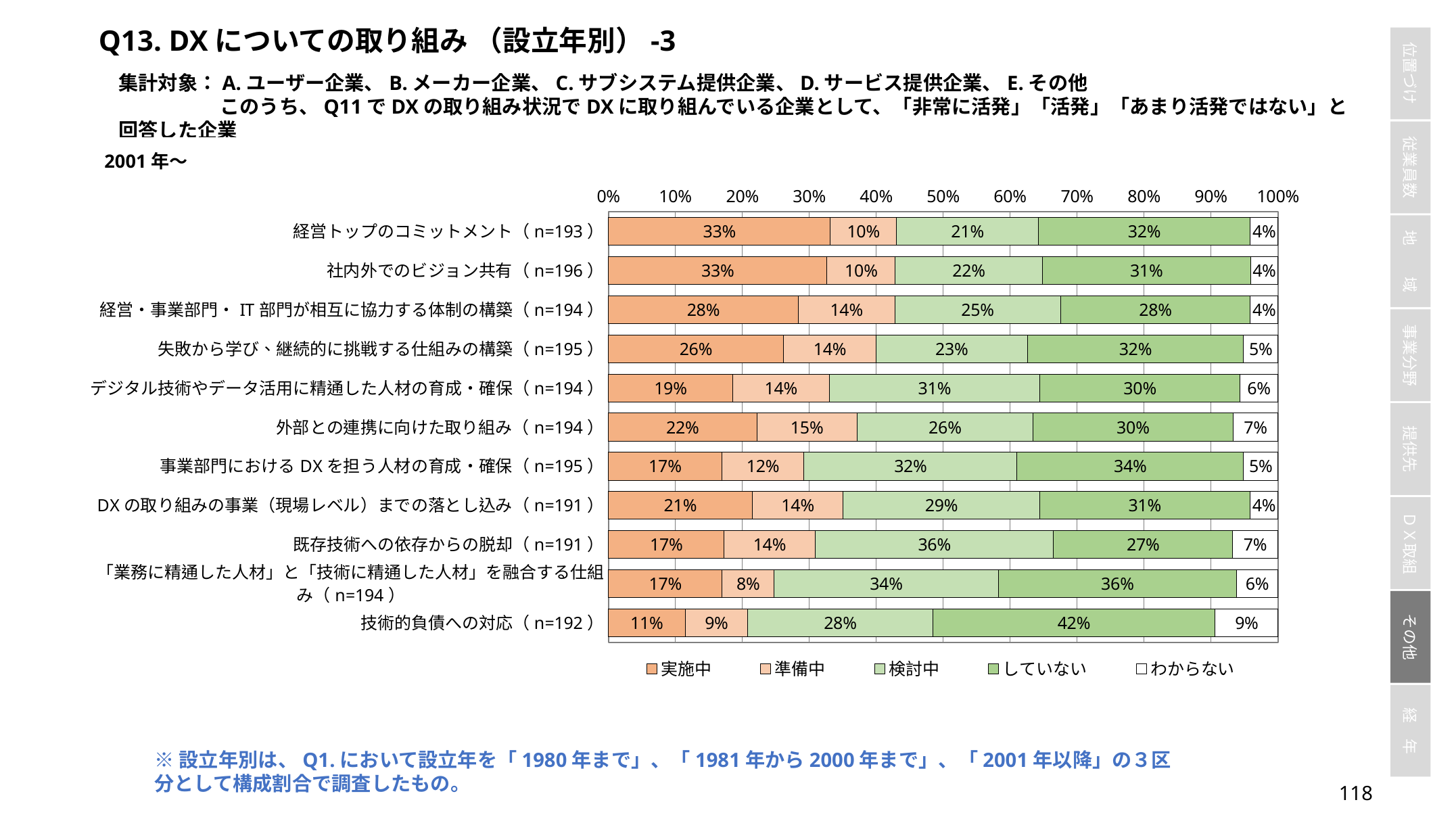
What is the していない value for 技術的負債への対応? 42% What is the difference between the 実施中 values for 経営トップのコミットメント and 技術的負債への対応? 22% Which category has the highest していない value? 技術的負債への対応 What is the 検討中 value for 既存技術への依存からの脱却? 36% Which category has the lowest 実施中 value? 技術的負債への対応 What type of chart is shown on the slide? Stacked bar chart What is the 実施中 value for 経営トップのコミットメント? 33% What is the sample size (n) shown for 社内外でのビジョン共有? n=196 Which is larger: the 検討中 value for 事業部門におけるDXを担う人材の育成・確保 or the 検討中 value for 外部との連携に向けた取り組み? 事業部門におけるDXを担う人材の育成・確保 How many series does the legend list? 5 What is the 準備中 value for 「業務に精通した人材」と「技術に精通した人材」を融合する仕組み? 8% How many categories (items) are plotted in the chart? 11